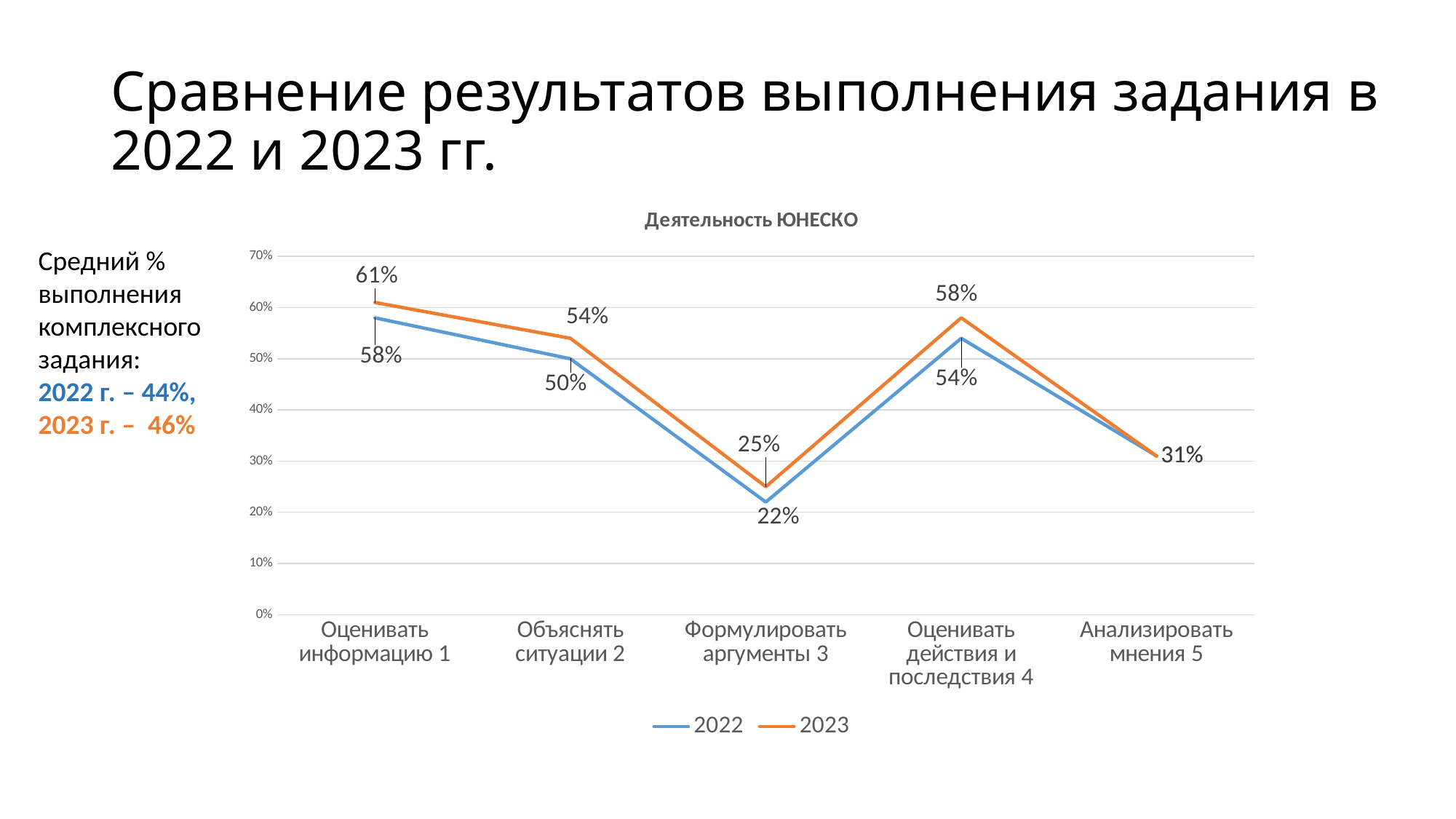
What is the 2022 value for Формулировать аргументы 3? 22% Which category has the lowest value for the 2023 series? Формулировать аргументы 3 What type of chart is shown on the slide? line chart What is the difference between the 2023 and 2022 values for Объяснять ситуации 2? 4% How many categories are shown on the x axis of the chart? 5 What is the 2023 value for Оценивать информацию 1? 61% What is the title of the chart? Деятельность ЮНЕСКО Which category has the highest value for the 2022 series? Оценивать информацию 1 What is the 2023 value for Оценивать действия и последствия 4? 58% How many series does the chart legend list? 2 Which is larger for Оценивать действия и последствия 4: the 2022 value or the 2023 value? 2023 What is the 2022 value for Объяснять ситуации 2? 50%